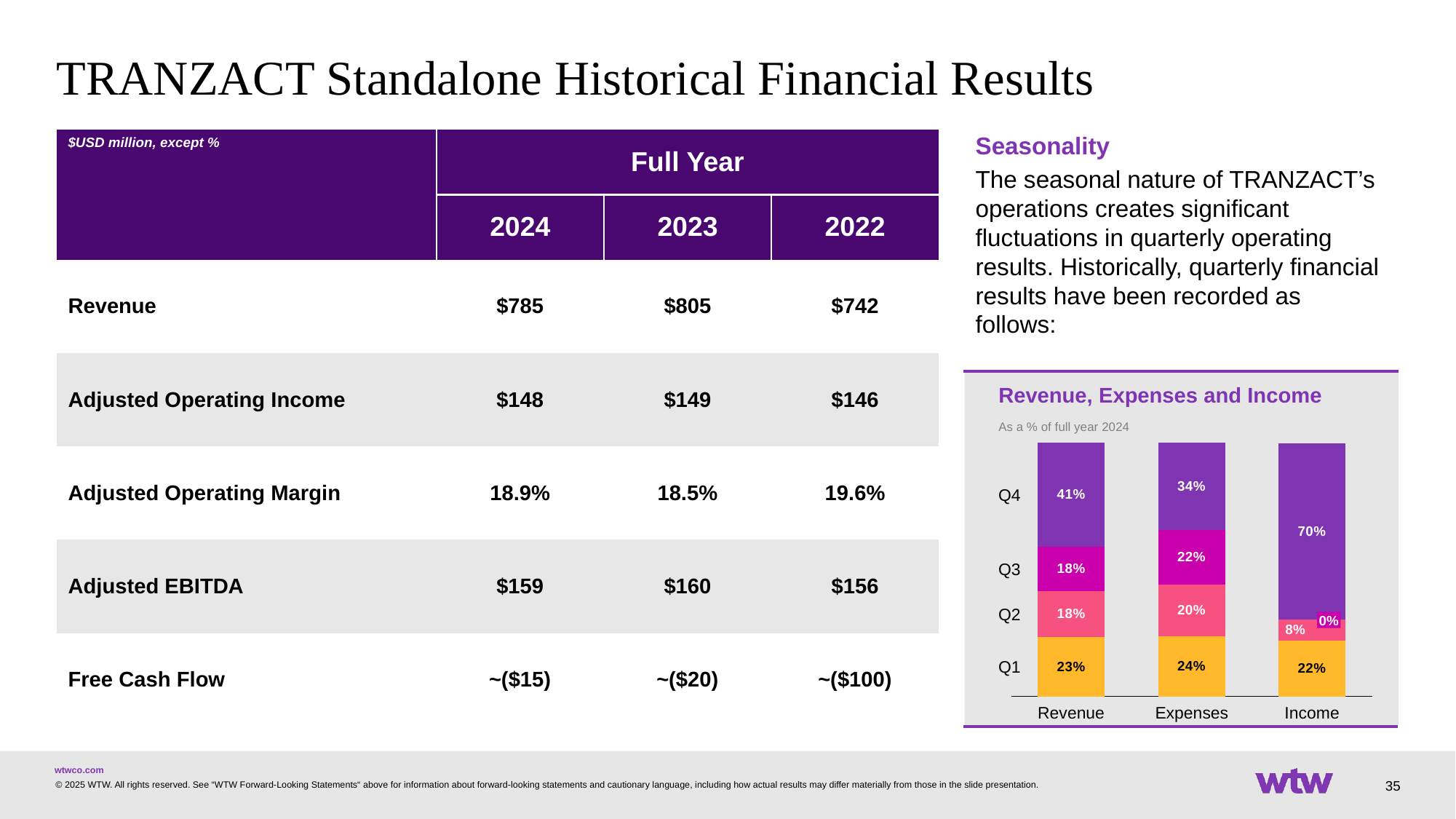
In the 'Revenue, Expenses and Income' chart, what is the Q3 value for Income? 0% In the 'Revenue, Expenses and Income' chart, what is the Q4 value for Revenue? 41% How many quarters (series) are stacked in each bar of the 'Revenue, Expenses and Income' chart? 4 In the 'Revenue, Expenses and Income' chart, which is larger: the Q3 value for Expenses or the Q3 value for Revenue? Expenses In the 'Revenue, Expenses and Income' chart, which category has the lowest Q2 value? Income What kind of chart is the 'Revenue, Expenses and Income' chart? Stacked bar chart In the 'Revenue, Expenses and Income' chart, what is the Q1 value for Expenses? 24% In the 'Revenue, Expenses and Income' chart, what is the Q4 value for Income? 70% In the 'Revenue, Expenses and Income' chart, which category has the highest Q4 value? Income How many categories are shown on the x axis of the 'Revenue, Expenses and Income' chart? 3 In the 'Revenue, Expenses and Income' chart, what is the Q2 value for Expenses? 20% In the 'Revenue, Expenses and Income' chart, what is the difference between the Q4 values for Income and Revenue? 29%